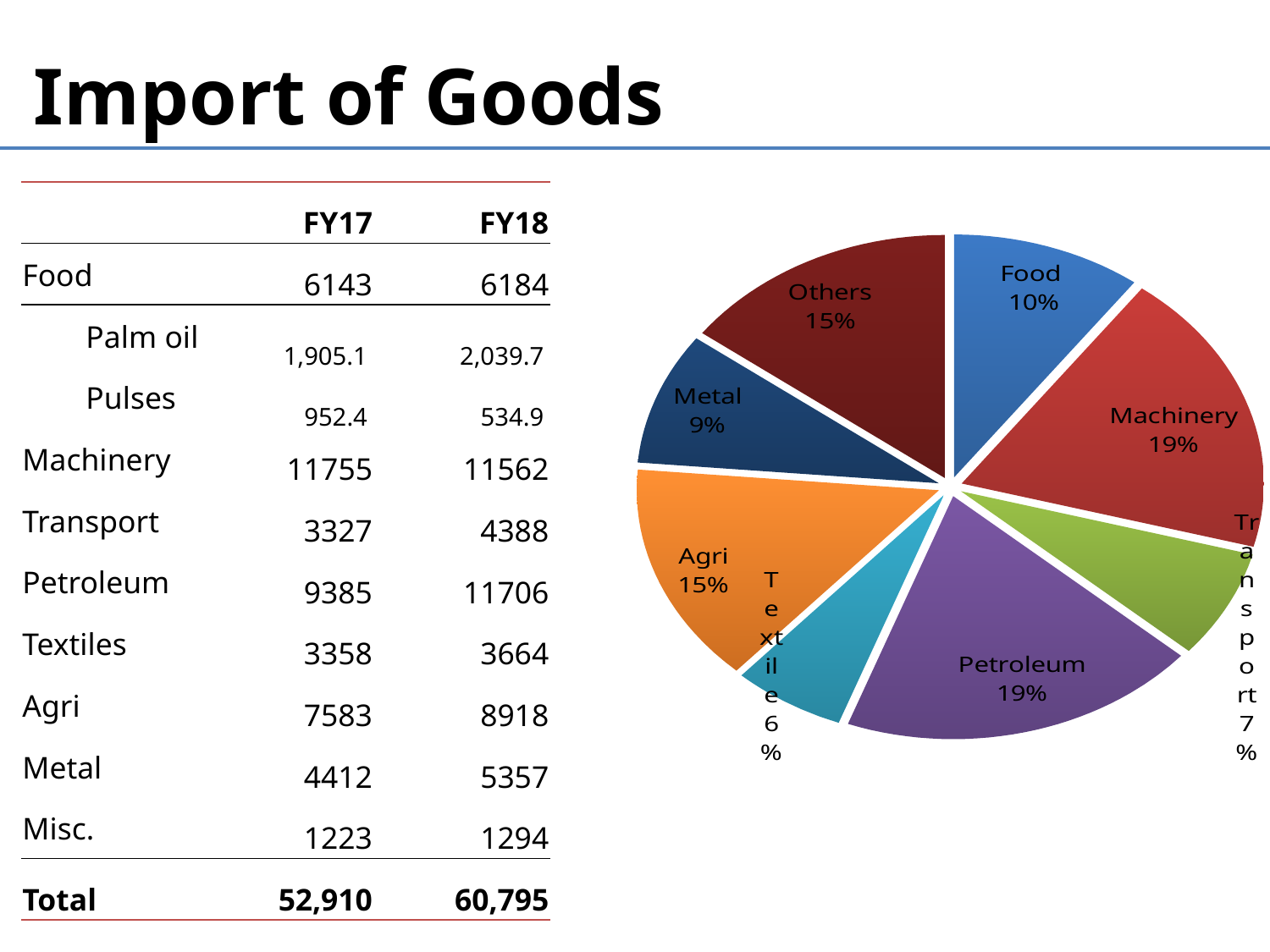
Which is larger in the pie chart, Agri or Food? Agri What percentage is shown for Others in the pie chart? 15% What colour is the Petroleum slice in the pie chart? purple What percentage is shown for Agri in the pie chart? 15% What percentage is shown for Food in the pie chart? 10% How many slices does the pie chart have? 8 What percentage is shown for Metal in the pie chart? 9% Which is larger in the pie chart, Machinery or Metal? Machinery What is the difference in percentage points between Machinery and Food in the pie chart? 9 What share of the pie does Petroleum account for? 19% Which slice of the pie chart is the smallest? Textile What kind of chart is shown on the slide? pie chart